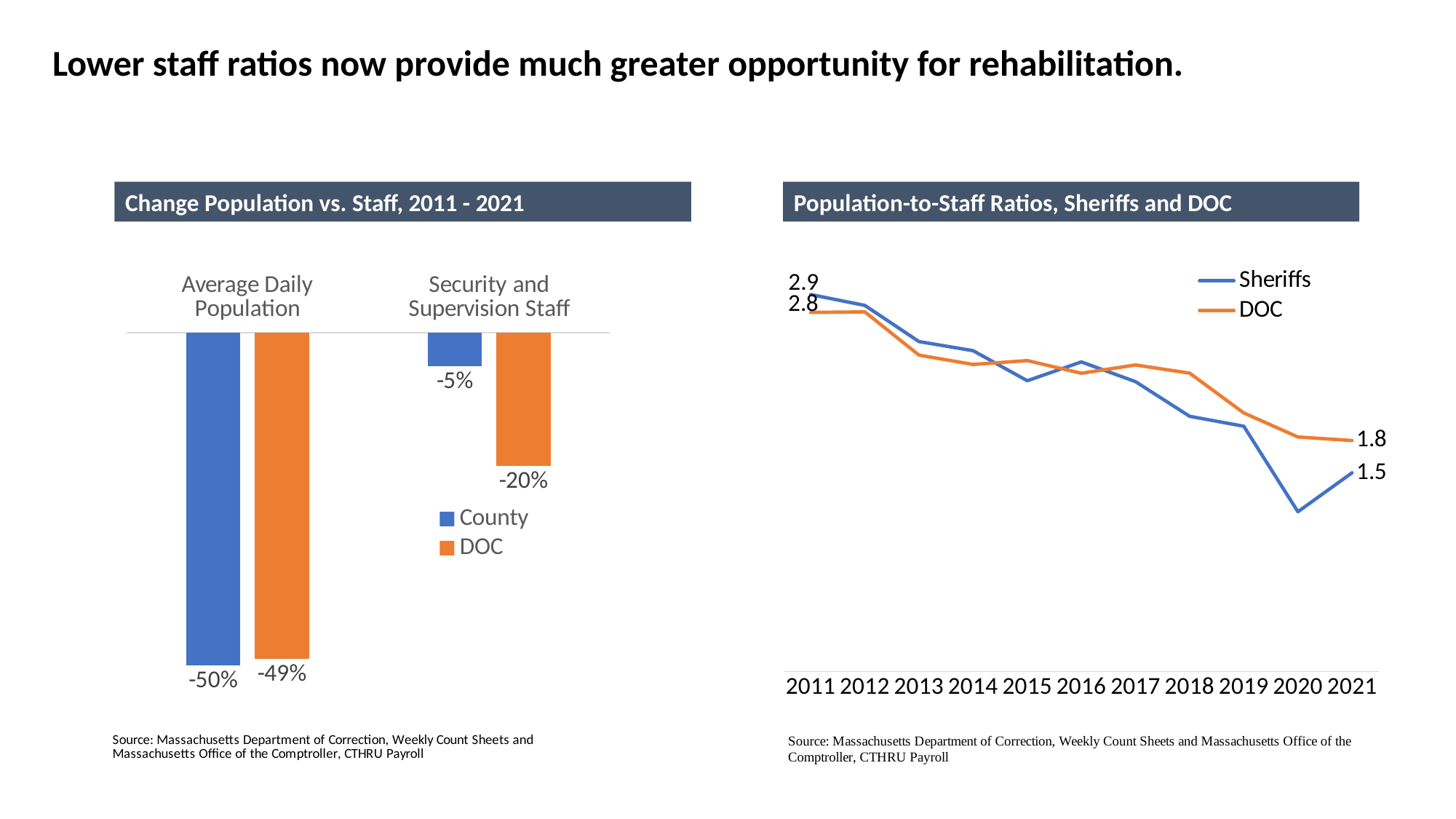
In the 'Population-to-Staff Ratios, Sheriffs and DOC' chart, what is the Sheriffs value in 2011? 2.9 In the 'Change Population vs. Staff, 2011 - 2021' chart, what is the difference between the County and DOC values under Security and Supervision Staff? 15 percentage points In the 'Population-to-Staff Ratios, Sheriffs and DOC' chart, do the Sheriffs values generally rise or fall from 2011 to 2021? Fall In the 'Population-to-Staff Ratios, Sheriffs and DOC' chart, what is the DOC value in 2021? 1.8 In the 'Change Population vs. Staff, 2011 - 2021' chart, what is the value for County under Average Daily Population? -50% In the 'Change Population vs. Staff, 2011 - 2021' chart, how many series does the legend list? 2 In the 'Change Population vs. Staff, 2011 - 2021' chart, what is the value for County under Security and Supervision Staff? -5% In the 'Population-to-Staff Ratios, Sheriffs and DOC' chart, what is the Sheriffs value in 2021? 1.5 In the 'Change Population vs. Staff, 2011 - 2021' chart, what is the value for DOC under Security and Supervision Staff? -20% In the 'Population-to-Staff Ratios, Sheriffs and DOC' chart, how many years are shown on the x axis? 11 In the 'Change Population vs. Staff, 2011 - 2021' chart, what is the value for DOC under Average Daily Population? -49% What kind of chart is 'Change Population vs. Staff, 2011 - 2021'? Bar chart